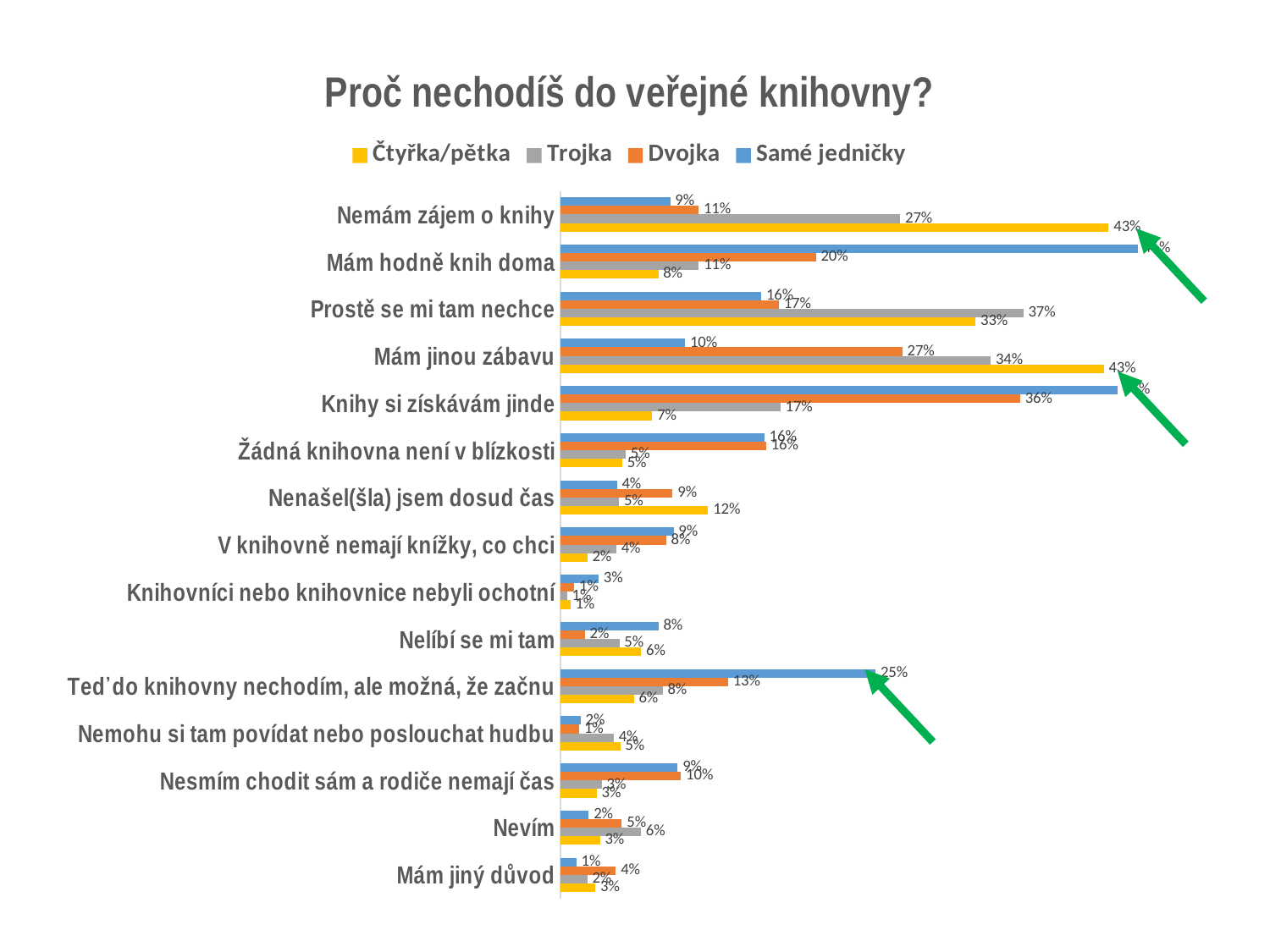
What is the difference between the Čtyřka/pětka and Trojka values in the category "Nemám zájem o knihy"? 16% What is the value for Samé jedničky in the category "Teď do knihovny nechodím, ale možná, že začnu"? 25% How many series does the legend list? 4 What is the title of the chart? Proč nechodíš do veřejné knihovny? What kind of chart is shown on the slide? Bar chart What is the value for Dvojka in the category "Knihy si získávám jinde"? 36% What is the value for Trojka in the category "Prostě se mi tam nechce"? 37% What is the value for Čtyřka/pětka in the category "Nemám zájem o knihy"? 43% Which series has the lowest value in the category "Nenašel(šla) jsem dosud čas"? Samé jedničky How many categories are shown on the chart? 15 Which is larger in the category "Mám hodně knih doma": the Dvojka value or the Trojka value? Dvojka Which series has the highest value in the category "Mám jinou zábavu"? Čtyřka/pětka